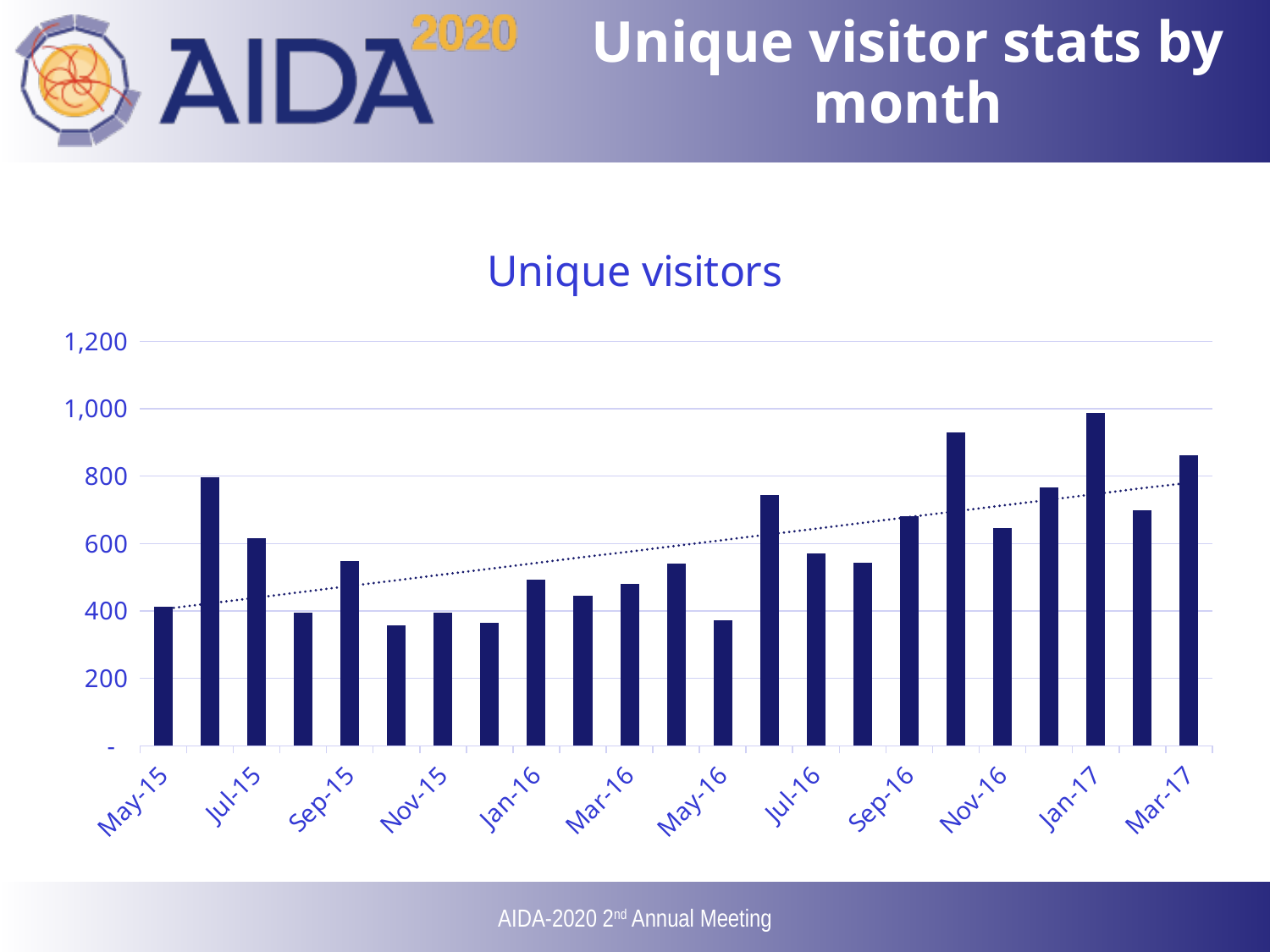
What kind of chart is shown on the slide? bar chart Is the value for May-16 greater or less than 400? less Which is larger, the value for Jan-16 or the value for May-16? Jan-16 Which month has the highest number of unique visitors? Jan-17 Does the dotted trend line rise or fall from May-15 to Mar-17? rise Is the value for Jan-17 greater or less than 800? greater Is the value for Jan-16 greater or less than 600? less How many bars are plotted in the chart? 23 Which is larger, the value for Jan-17 or the value for Mar-17? Jan-17 What is the title of the chart? Unique visitors